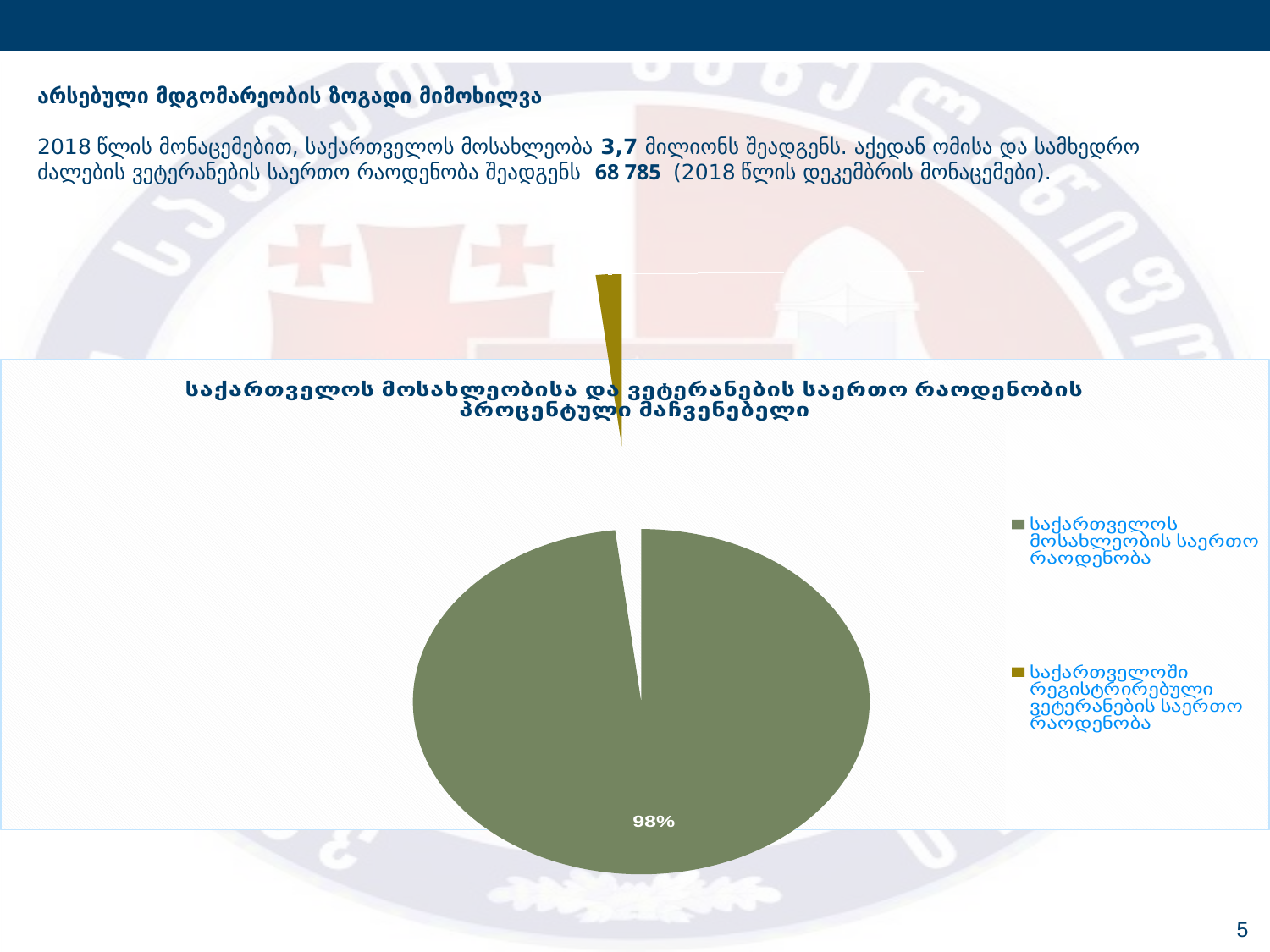
How many entries does the legend of the pie chart list? 2 Which slice of the pie chart is the largest? საქართველოს მოსახლეობის საერთო რაოდენობა What colour is the slice for "საქართველოს მოსახლეობის საერთო რაოდენობა" in the pie chart? green What percentage is shown for the slice "საქართველოს მოსახლეობის საერთო რაოდენობა"? 98% Which slice of the pie chart is the smallest? საქართველოში რეგისტრირებული ვეტერანების საერთო რაოდენობა Which is larger in the pie chart: the slice for "საქართველოს მოსახლეობის საერთო რაოდენობა" or the slice for "საქართველოში რეგისტრირებული ვეტერანების საერთო რაოდენობა"? საქართველოს მოსახლეობის საერთო რაოდენობა What is the title of the pie chart? საქართველოს მოსახლეობისა და ვეტერანების საერთო რაოდენობის პროცენტული მაჩვენებელი How many slices does the pie chart have? 2 What kind of chart is shown on the slide? pie chart What share of the pie does the slice "საქართველოს მოსახლეობის საერთო რაოდენობა" take? 98%